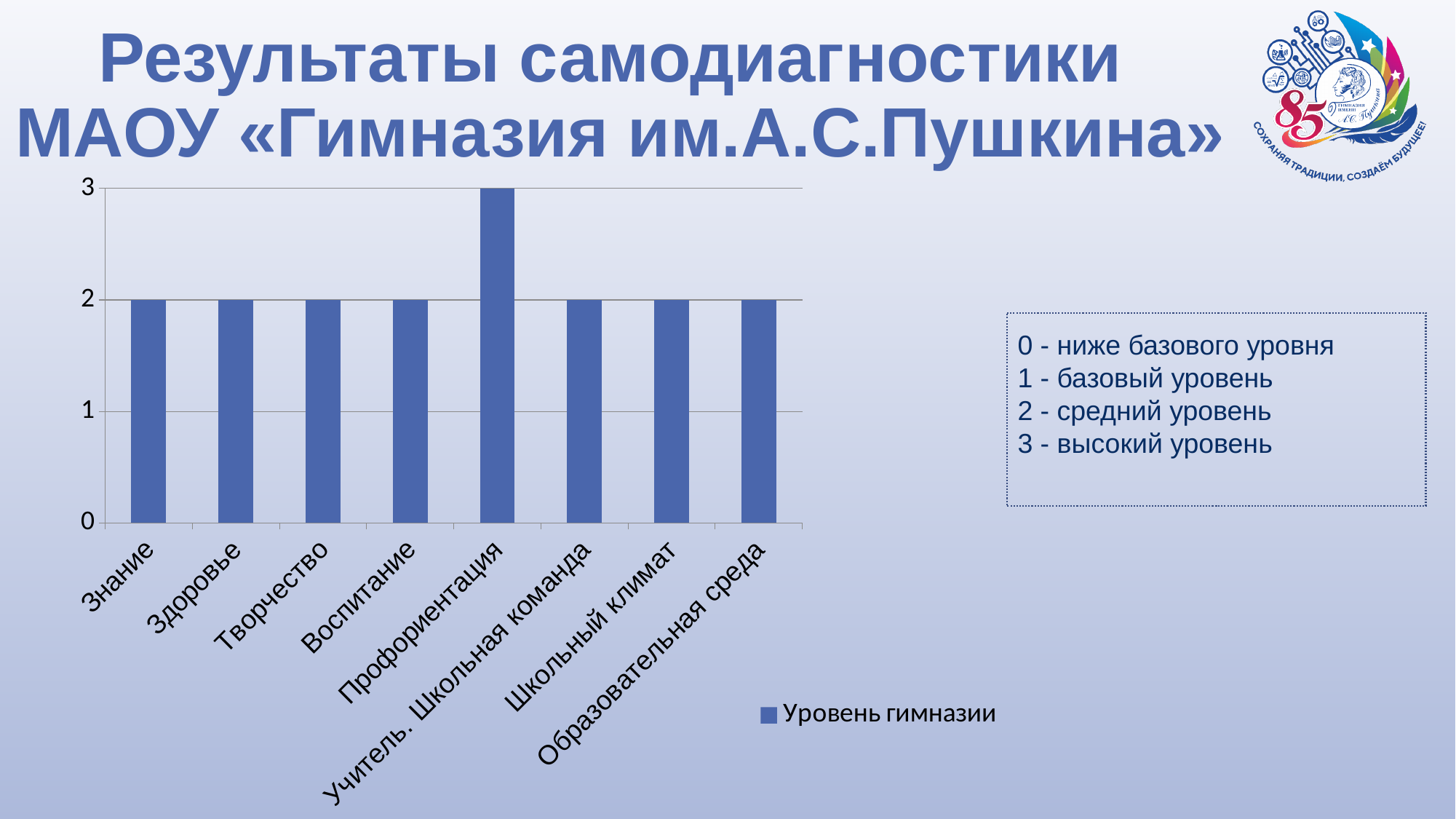
What is the value for Образовательная среда? 2 Which category has the highest value in the chart? Профориентация What is the value for Знание? 2 How many categories have a value of 2? 7 How many series does the chart legend list? 1 What is the name of the series shown in the chart legend? Уровень гимназии What is the value for Профориентация? 3 What is the difference between the values for Профориентация and Здоровье? 1 Which is larger, the value for Профориентация or the value for Школьный климат? Профориентация How many categories are plotted on the x axis of the chart? 8 Is the value for Воспитание greater or less than 3? less What type of chart is shown on the slide? Bar chart